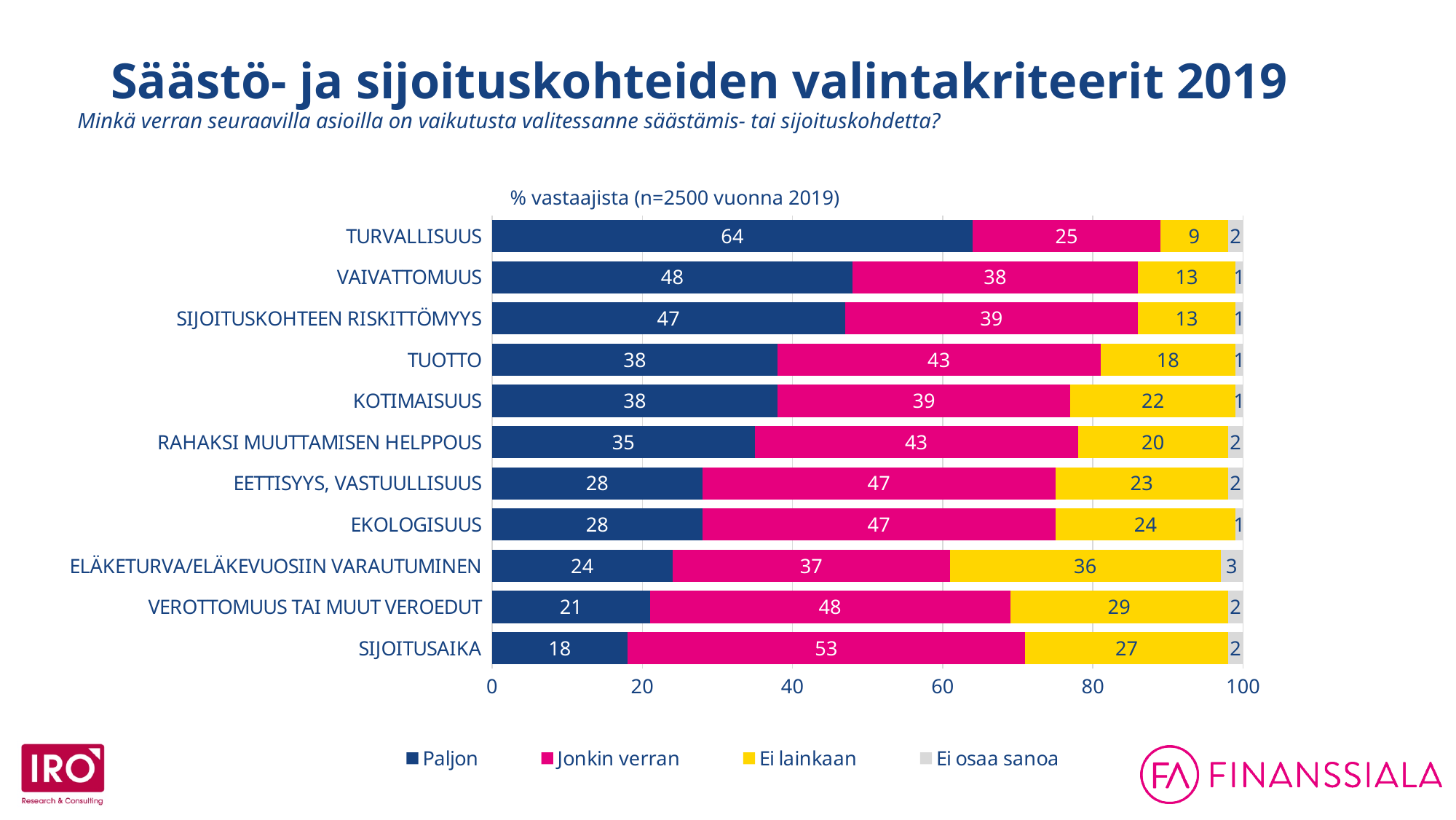
What is the total of the stacked bar for EKOLOGISUUS? 100 What is the 'Jonkin verran' value for SIJOITUSAIKA? 53 Which is larger, the 'Ei lainkaan' value for TUOTTO or for KOTIMAISUUS? KOTIMAISUUS What is the 'Ei lainkaan' value for ELÄKETURVA/ELÄKEVUOSIIN VARAUTUMINEN? 36 How many series does the legend list? 4 How many categories are shown on the chart? 11 Which category has the highest 'Paljon' value? TURVALLISUUS What is the difference between the 'Paljon' values for TURVALLISUUS and VAIVATTOMUUS? 16 What is the 'Paljon' value for TURVALLISUUS? 64 What type of chart is shown on the slide? Stacked bar chart What is the subtitle shown above the chart? % vastaajista (n=2500 vuonna 2019) Which category has the lowest 'Paljon' value? SIJOITUSAIKA